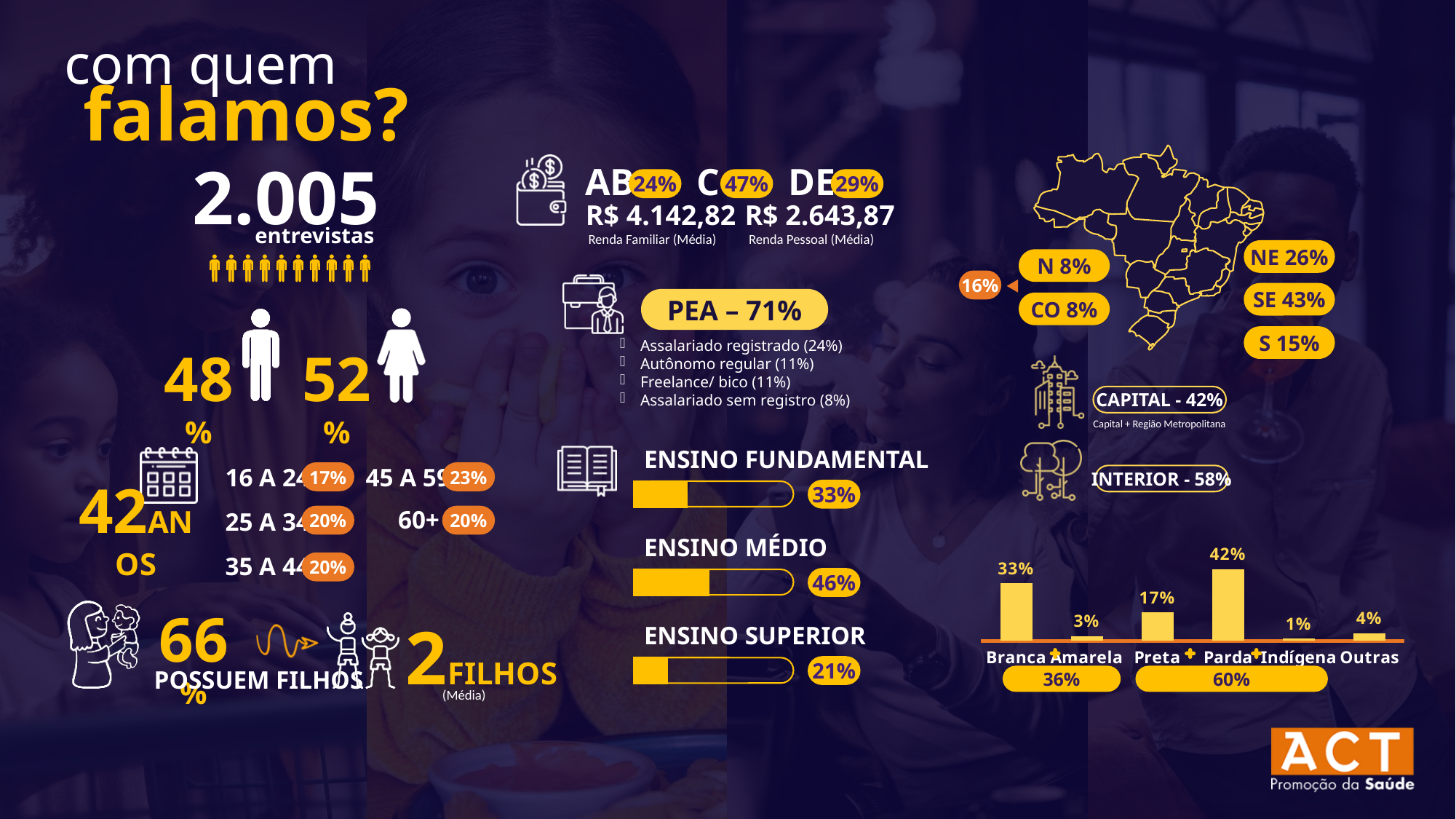
What kind of chart is shown at the bottom right of the slide? Bar chart In the bar chart at the bottom right of the slide, what is the value for Parda? 42% In the bar chart at the bottom right of the slide, which is larger, the value for Preta or the value for Amarela? Preta In the bar chart at the bottom right of the slide, what is the value for Outras? 4% In the education bars in the middle of the slide, which level has the lowest value? Ensino Superior In the bar chart at the bottom right of the slide, what is the difference between the values for Parda and Branca? 9 percentage points In the bar chart at the bottom right of the slide, what is the combined value of Branca and Amarela? 36% In the bar chart at the bottom right of the slide, which category has the lowest value? Indígena In the bar chart at the bottom right of the slide, which category has the highest value? Parda In the education bars in the middle of the slide, what is the value for Ensino Médio? 46% In the bar chart at the bottom right of the slide, what is the value for Branca? 33% How many categories are shown in the bar chart at the bottom right of the slide? 6